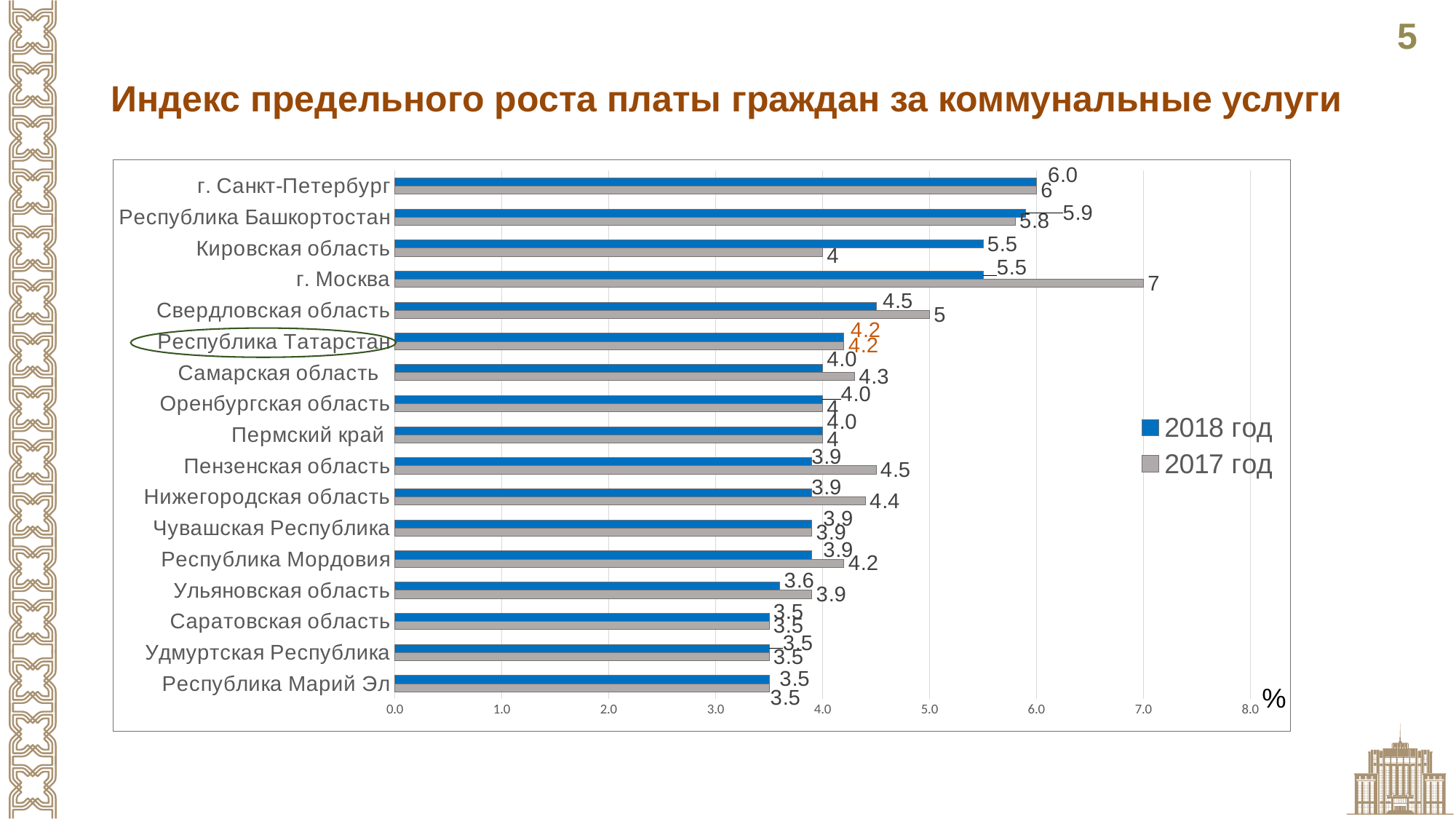
What is the difference between the 2018 год and 2017 год values for Кировская область? 1.5 How many regions are shown on the chart? 17 What is the value for Пензенская область in the 2017 год series? 4.5 What is the value for Кировская область in the 2018 год series? 5.5 Which category has the highest value in the 2017 год series? г. Москва For Свердловская область, which series has the larger value, 2018 год or 2017 год? 2017 год What is the value for г. Москва in the 2017 год series? 7 How many series does the legend list? 2 What is the difference between the 2017 год and 2018 год values for г. Москва? 1.5 What is the value for Республика Татарстан in the 2018 год series? 4.2 What kind of chart is shown on the slide? Bar chart Which category has the highest value in the 2018 год series? г. Санкт-Петербург